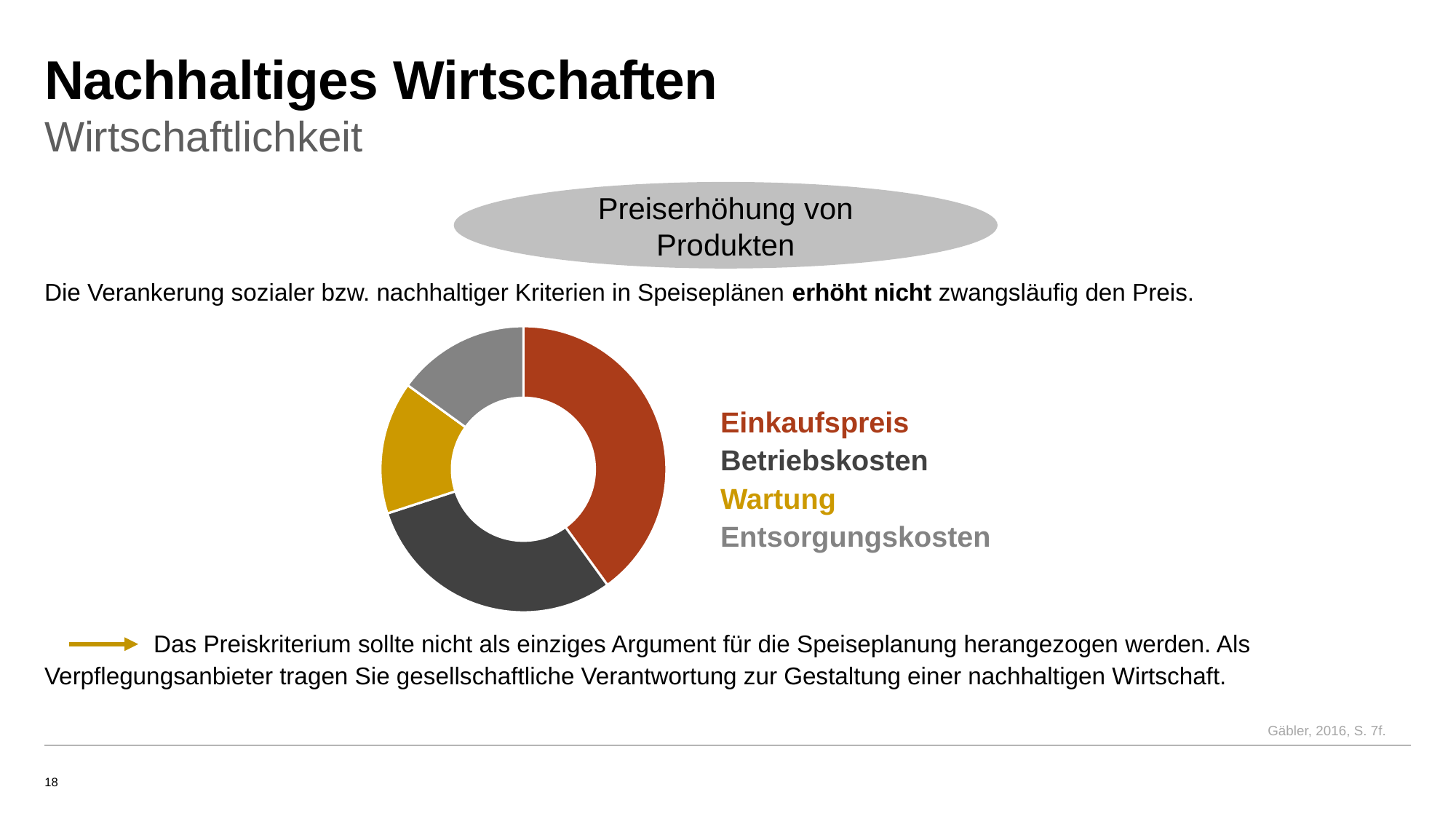
Which category is shown in gold/yellow in the donut chart? Wartung Which is larger in the donut chart, Einkaufspreis or Entsorgungskosten? Einkaufspreis Which is larger in the donut chart, Betriebskosten or Wartung? Betriebskosten Which category is shown in light grey in the donut chart? Entsorgungskosten Which is larger in the donut chart, Einkaufspreis or Betriebskosten? Einkaufspreis Which category has the largest share of the donut chart? Einkaufspreis What kind of chart is shown on the slide? Donut (pie) chart How many categories does the donut chart show? 4